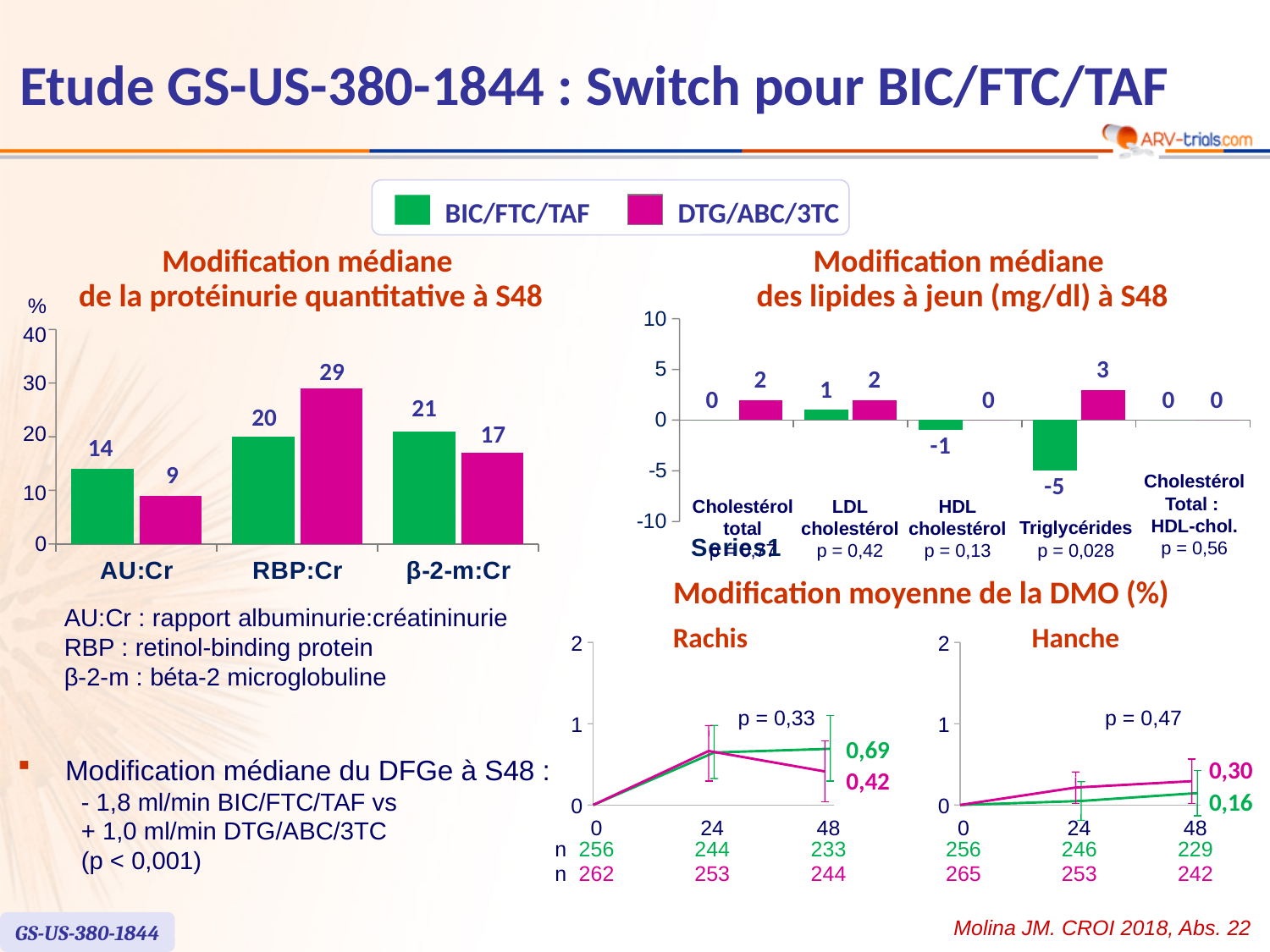
In the chart 'Modification médiane de la protéinurie quantitative à S48', how many categories are shown on the x axis? 3 In the 'Rachis' chart, what is the BIC/FTC/TAF value at week 48? 0,69 In the chart 'Modification médiane de la protéinurie quantitative à S48', which category has the highest DTG/ABC/3TC value? RBP:Cr In the chart 'Modification médiane des lipides à jeun (mg/dl) à S48', which is larger for HDL cholestérol: BIC/FTC/TAF or DTG/ABC/3TC? DTG/ABC/3TC In the chart 'Modification médiane des lipides à jeun (mg/dl) à S48', which category has the lowest BIC/FTC/TAF value? Triglycérides In the chart 'Modification médiane de la protéinurie quantitative à S48', what is the value for BIC/FTC/TAF for RBP:Cr? 20 In the chart 'Modification médiane des lipides à jeun (mg/dl) à S48', what is the DTG/ABC/3TC value for LDL cholestérol? 2 How many series does the legend at the top of the slide list? 2 In the chart 'Modification médiane de la protéinurie quantitative à S48', what is the value for DTG/ABC/3TC for AU:Cr? 9 In the chart 'Modification médiane de la protéinurie quantitative à S48', what is the difference between the DTG/ABC/3TC and BIC/FTC/TAF values for RBP:Cr? 9 In the 'Hanche' chart, what is the DTG/ABC/3TC value at week 48? 0,30 In the chart 'Modification médiane des lipides à jeun (mg/dl) à S48', what is the BIC/FTC/TAF value for Triglycérides? -5